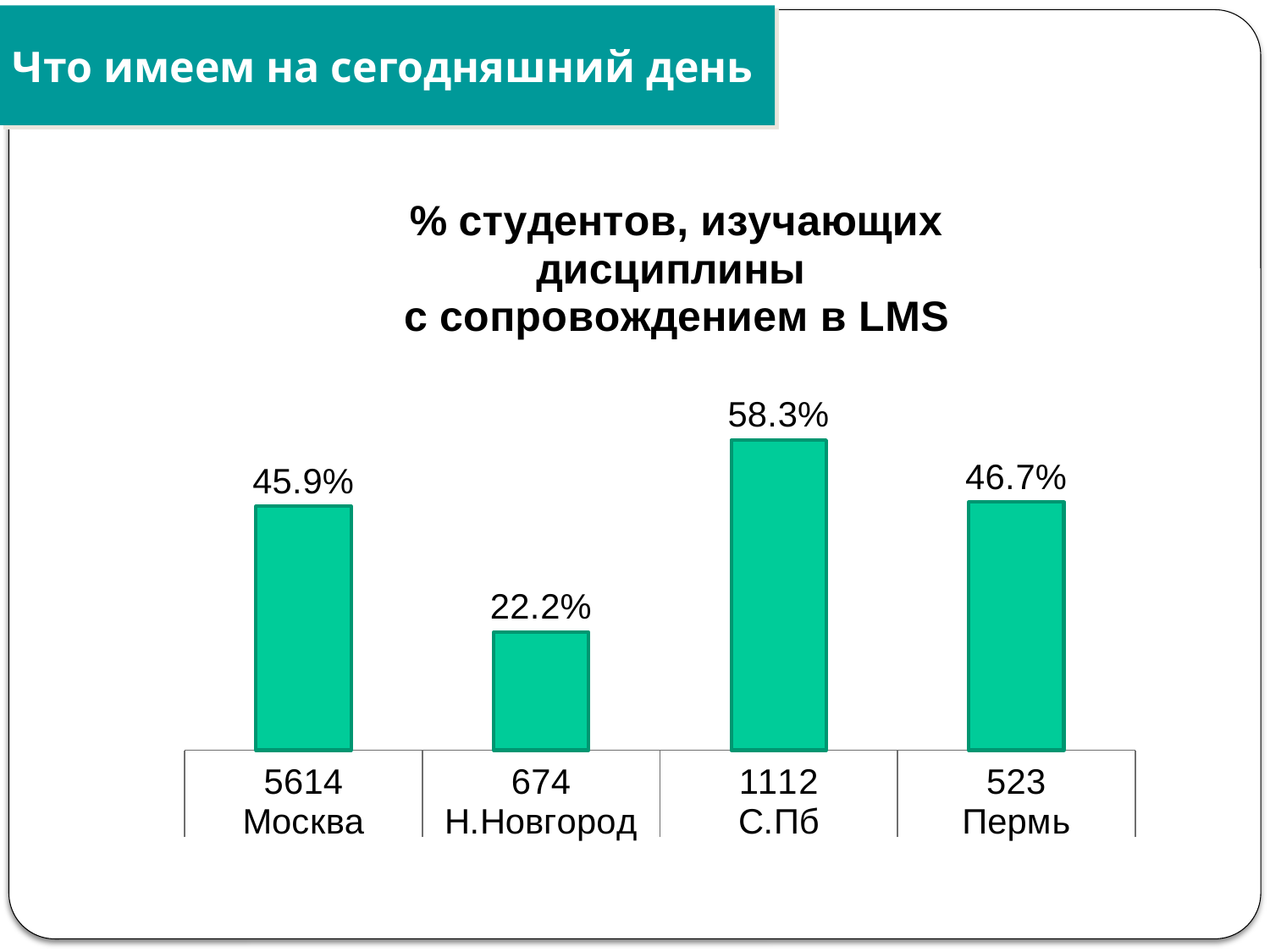
What type of chart is shown on the slide? Bar chart What percentage is shown for Пермь? 46.7% How many cities are shown in the chart? 4 Which city has the highest percentage of students studying disciplines with LMS support? С.Пб What is the difference in percentage points between Пермь and Москва? 0.8 What number is printed under the Москва category label? 5614 What percentage is shown for Н.Новгород? 22.2% What percentage is shown for С.Пб? 58.3% What is the difference in percentage points between С.Пб and Н.Новгород? 36.1 What percentage is shown for Москва? 45.9% Which has a higher percentage, Москва or С.Пб? С.Пб Which city has the lowest percentage of students studying disciplines with LMS support? Н.Новгород